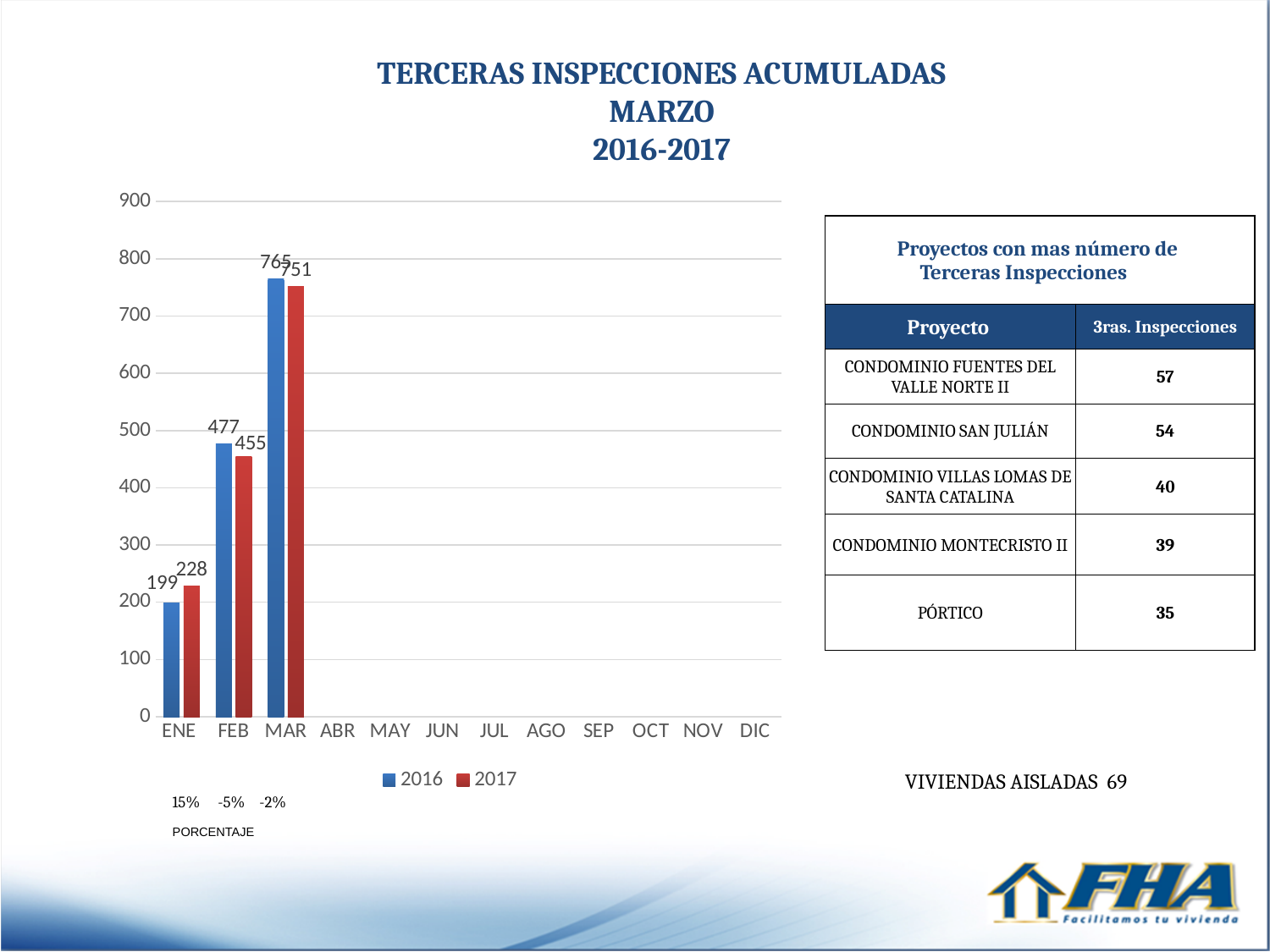
How many series does the legend list? 2 What is the difference between the 2016 and 2017 values in MAR? 14 Is the 2017 value for MAR greater or less than 700? greater Which month has the lowest value for the 2017 series? ENE Do the 2016 values rise or fall from ENE to MAR? Rise What is the value for 2017 in MAR? 751 What is the value for 2016 in ENE? 199 What is the difference between the 2017 and 2016 values in ENE? 29 What kind of chart is shown on the slide? Bar chart What is the value for 2017 in FEB? 455 Which month has the highest value for the 2016 series? MAR Which is larger in FEB, the 2016 value or the 2017 value? 2016